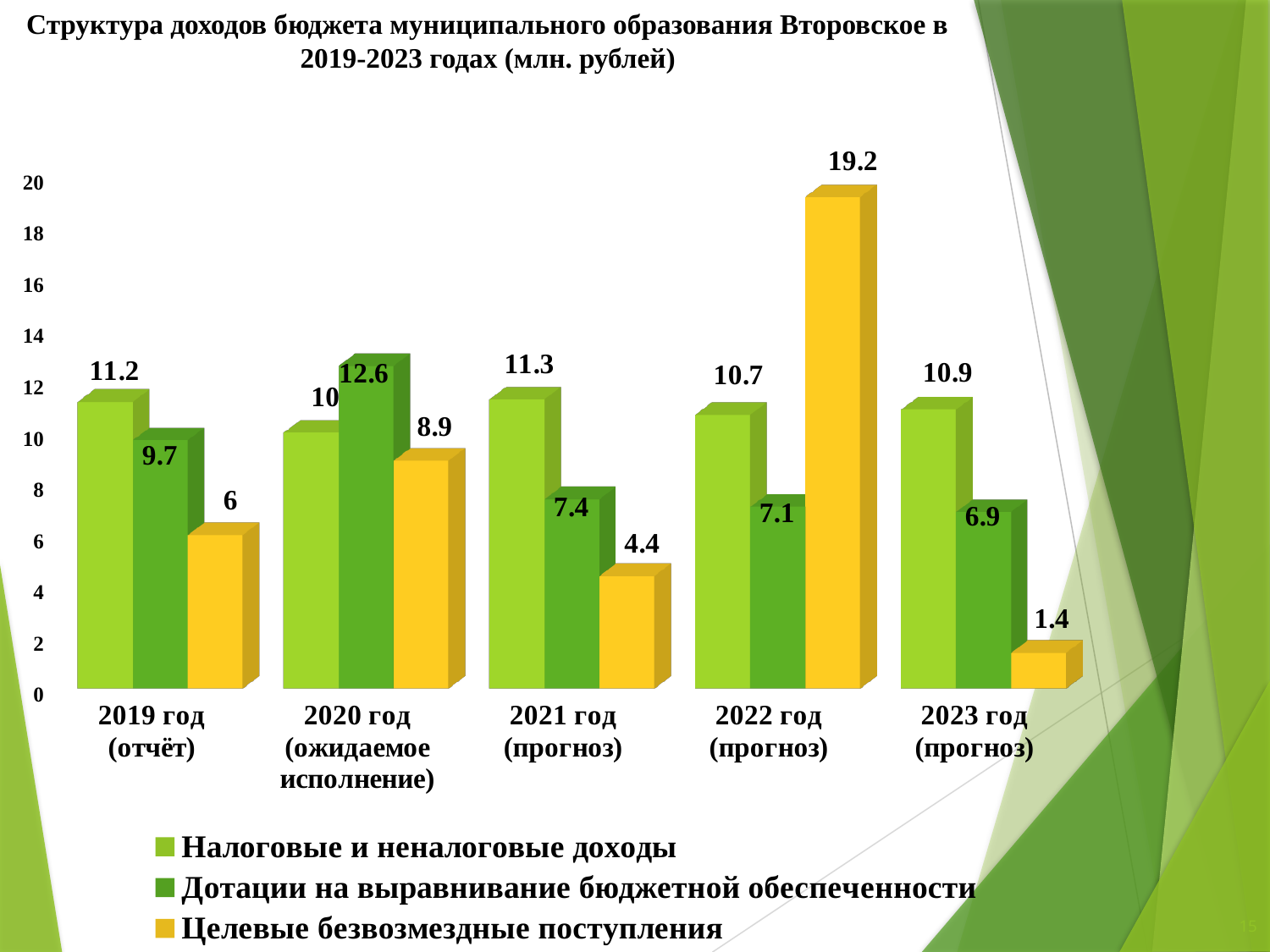
Which is larger in 2021 год (прогноз): Налоговые и неналоговые доходы or Дотации на выравнивание бюджетной обеспеченности? Налоговые и неналоговые доходы In which year is Целевые безвозмездные поступления the lowest? 2023 год (прогноз) What is the value of Налоговые и неналоговые доходы for 2019 год (отчёт)? 11.2 Is the value of Целевые безвозмездные поступления for 2020 год (ожидаемое исполнение) greater or less than 10? less Does Дотации на выравнивание бюджетной обеспеченности rise or fall from 2020 год to 2023 год? fall What is the value of Дотации на выравнивание бюджетной обеспеченности for 2020 год (ожидаемое исполнение)? 12.6 What is the value of Целевые безвозмездные поступления for 2022 год (прогноз)? 19.2 How many year categories are shown on the x axis? 5 How many series does the legend list? 3 What kind of chart is shown on the slide? bar chart In which year is Дотации на выравнивание бюджетной обеспеченности the highest? 2020 год (ожидаемое исполнение) What is the difference between Целевые безвозмездные поступления in 2022 год (прогноз) and in 2023 год (прогноз)? 17.8